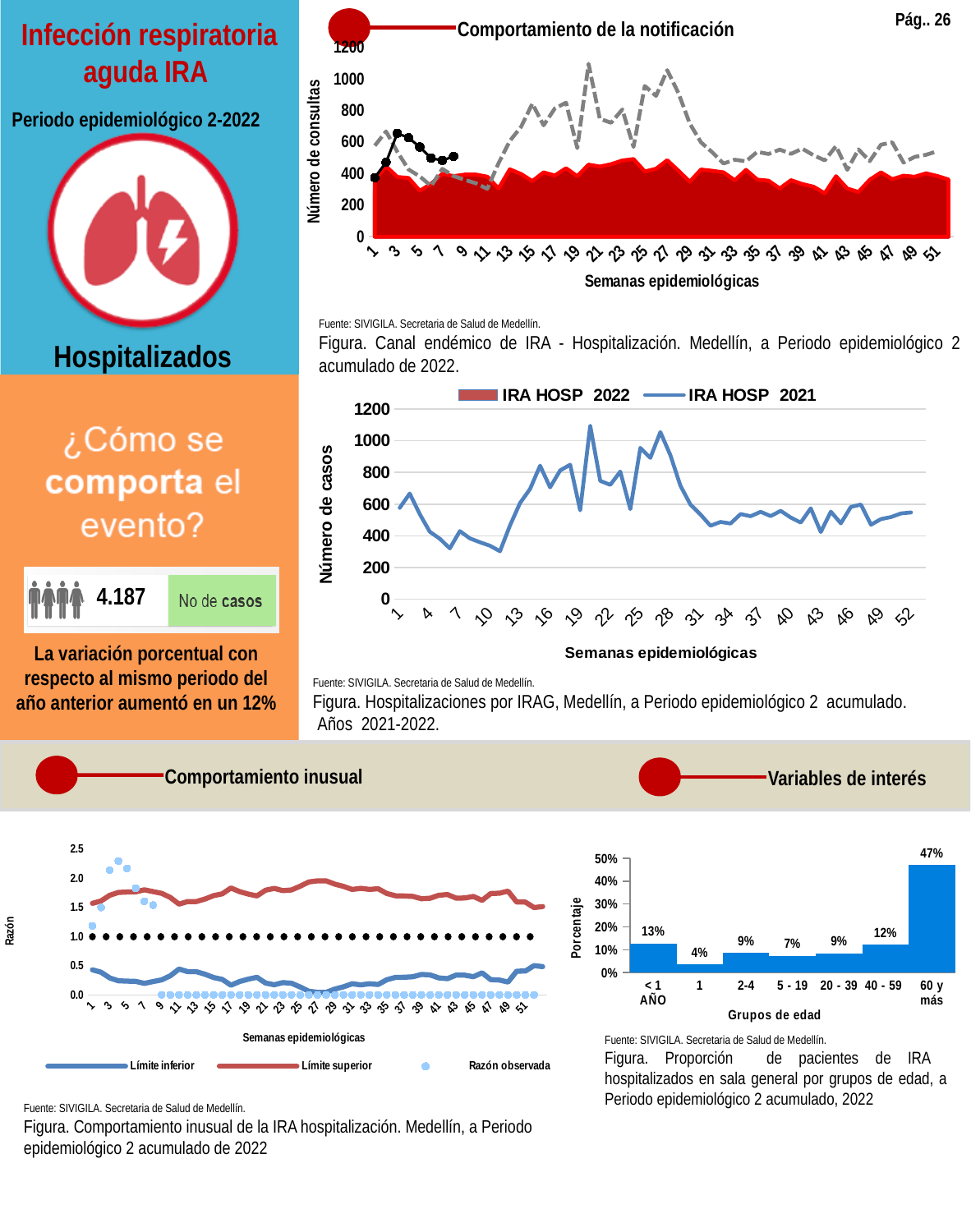
In the bar chart of age groups (bottom right), what is the percentage for the '60 y más' group? 47% What kind of chart is the 'Grupos de edad' chart at the bottom right? bar chart In the 'Hospitalizaciones por IRAG' line chart (middle right), is the IRA HOSP 2021 value at week 10 greater or less than 400? less In the bar chart of age groups (bottom right), which is larger: the value for '2-4' or the value for '5 - 19'? 2-4 In the bar chart of age groups (bottom right), which age group has the highest percentage? 60 y más In the bar chart of age groups (bottom right), which age group has the lowest percentage? 1 How many series does the legend list in the 'Hospitalizaciones por IRAG' line chart (middle right)? 2 In the bar chart of age groups (bottom right), what is the percentage for the '< 1 AÑO' group? 13% In the 'Hospitalizaciones por IRAG' line chart (middle right), is the peak value of the IRA HOSP 2021 line around week 19 greater or less than 1000? greater How many age groups are shown in the bar chart at the bottom right? 7 How many series does the legend list in the 'Comportamiento inusual' chart (bottom left)? 3 In the bar chart of age groups (bottom right), what is the difference between the '60 y más' group and the '40 - 59' group? 35%